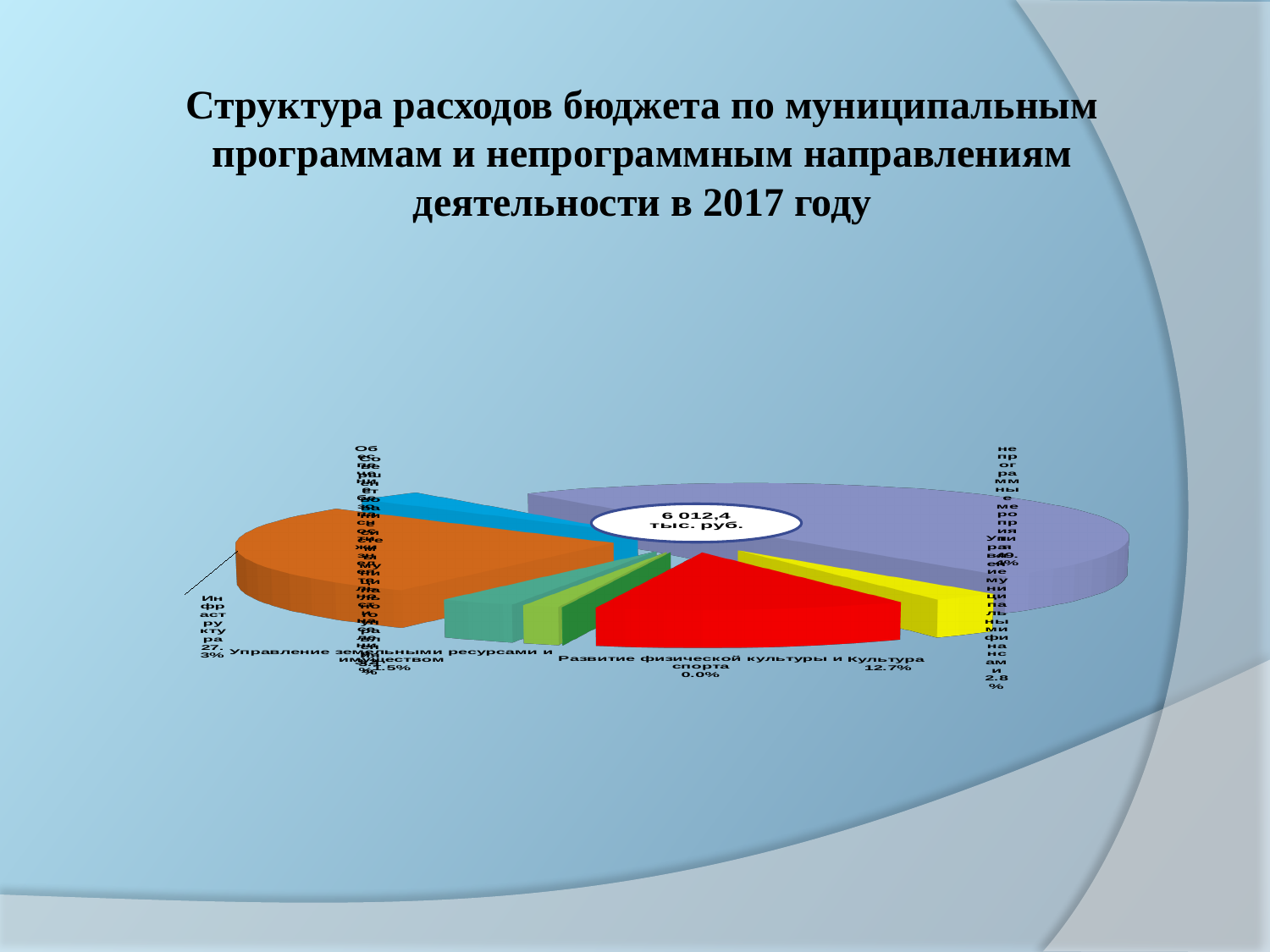
Which year does the chart title say the budget expenditure structure refers to? 2017 What share of the pie does "Инфраструктура" have? 27.3% Which labelled category has the smallest share of the pie? Развитие физической культуры и спорта What kind of chart is shown on the slide? pie chart Which is larger, the share for "Инфраструктура" or the share for "Культура"? Инфраструктура What share of the pie does "Управление земельными ресурсами и имуществом" have? 1.5% What share of the pie does "Культура" have? 12.7% What is the difference in percentage points between the "Культура" share and the "Управление земельными ресурсами и имуществом" share? 11.2 Which is larger, the share for "Культура" or the share for "Управление земельными ресурсами и имуществом"? Культура What total value is printed in the centre of the pie chart? 6 012,4 тыс. руб.